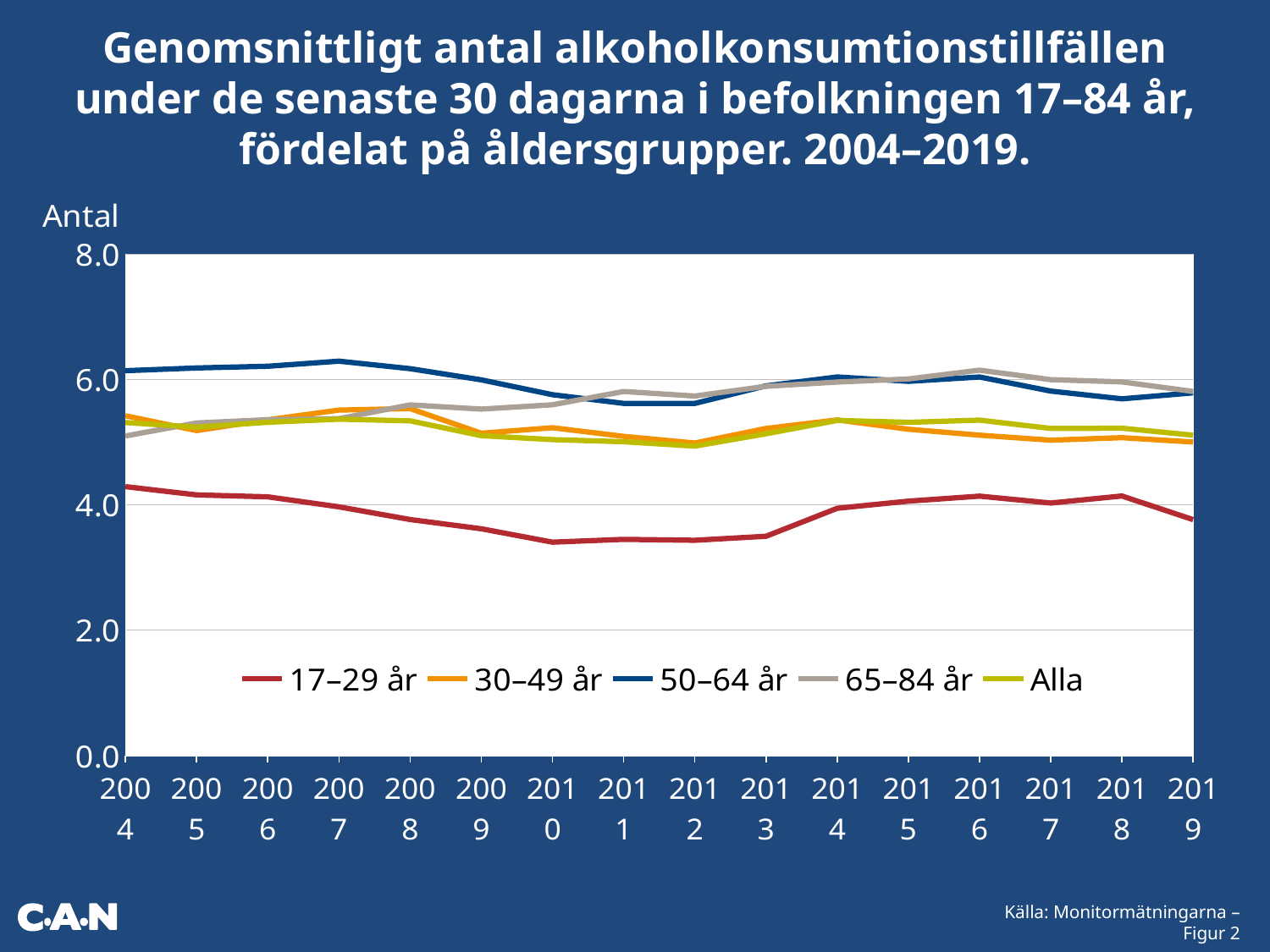
Is the value for 17–29 år in 2019 greater or less than 4.0? less Which series has the highest value in 2007? 50–64 år Is the value for 17–29 år in 2004 greater or less than 4.0? greater How many years are plotted along the x axis? 16 Does the 17–29 år line rise or fall from 2004 to 2010? fall In 2010, which is larger: the value for 17–29 år or the value for 50–64 år? 50–64 år How many series does the legend list? 5 What is the label on the y axis? Antal Is the value for 17–29 år in 2010 greater or less than 4.0? less Which series has the lowest values across the whole period? 17–29 år What kind of chart is shown on the slide? line chart